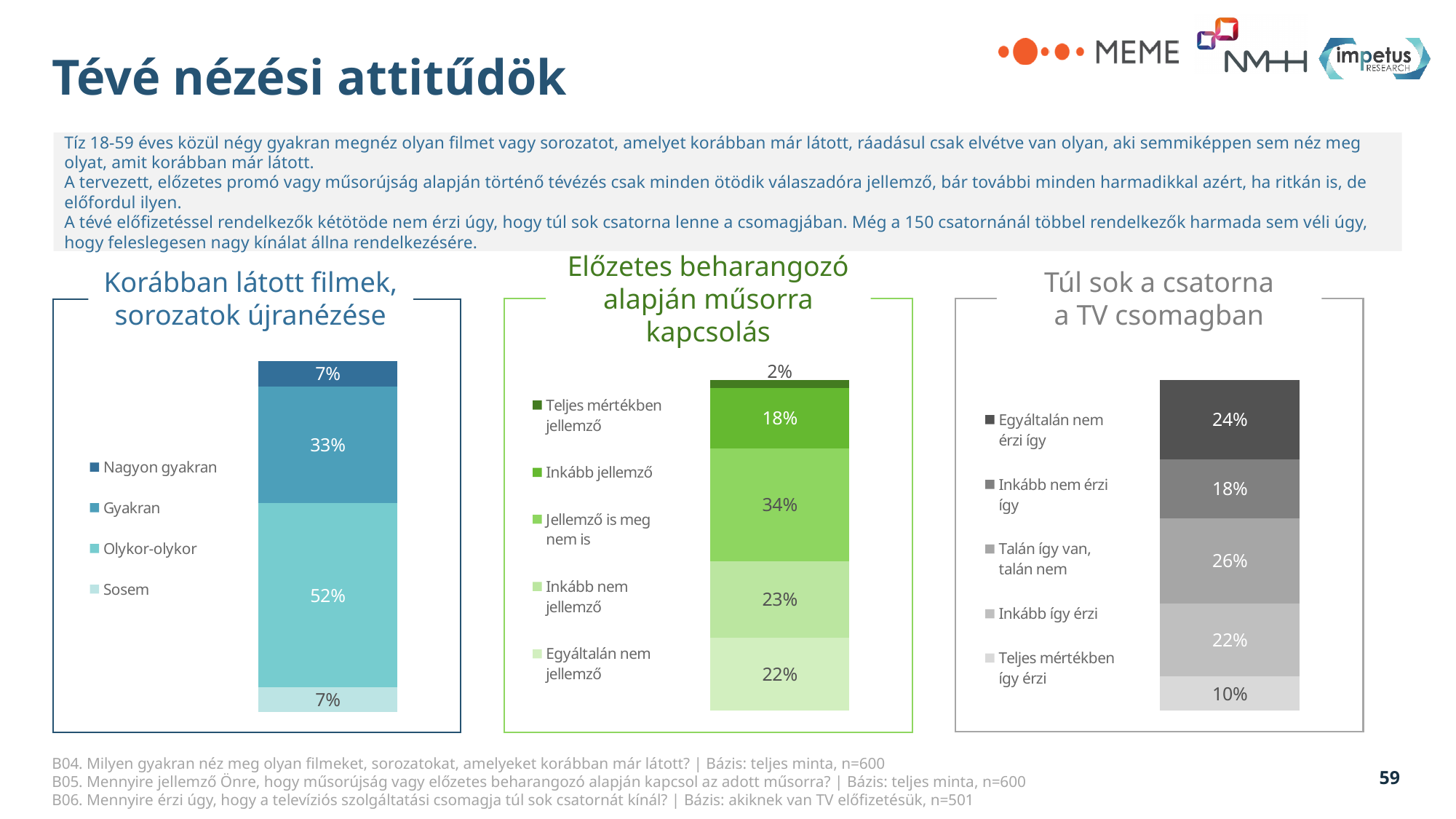
In the chart 'Előzetes beharangozó alapján műsorra kapcsolás', which is larger: 'Inkább jellemző' or 'Egyáltalán nem jellemző'? Egyáltalán nem jellemző In the chart 'Túl sok a csatorna a TV csomagban', which category has the smallest share? Teljes mértékben így érzi In the chart 'Előzetes beharangozó alapján műsorra kapcsolás', what is the value for 'Teljes mértékben jellemző'? 2% In the chart 'Túl sok a csatorna a TV csomagban', what is the difference between 'Egyáltalán nem érzi így' and 'Inkább nem érzi így'? 6 percentage points In the chart 'Korábban látott filmek, sorozatok újranézése', how many categories does the legend list? 4 In the chart 'Korábban látott filmek, sorozatok újranézése', what is the value for 'Olykor-olykor'? 52% In the chart 'Túl sok a csatorna a TV csomagban', what is the value for 'Talán így van, talán nem'? 26% In the chart 'Előzetes beharangozó alapján műsorra kapcsolás', which category has the smallest share? Teljes mértékben jellemző What type of chart is used for 'Túl sok a csatorna a TV csomagban'? Stacked bar chart In the chart 'Korábban látott filmek, sorozatok újranézése', which category has the largest share? Olykor-olykor In the chart 'Korábban látott filmek, sorozatok újranézése', what is the value for 'Gyakran'? 33% In the chart 'Előzetes beharangozó alapján műsorra kapcsolás', what is the difference between 'Jellemző is meg nem is' and 'Inkább nem jellemző'? 11 percentage points